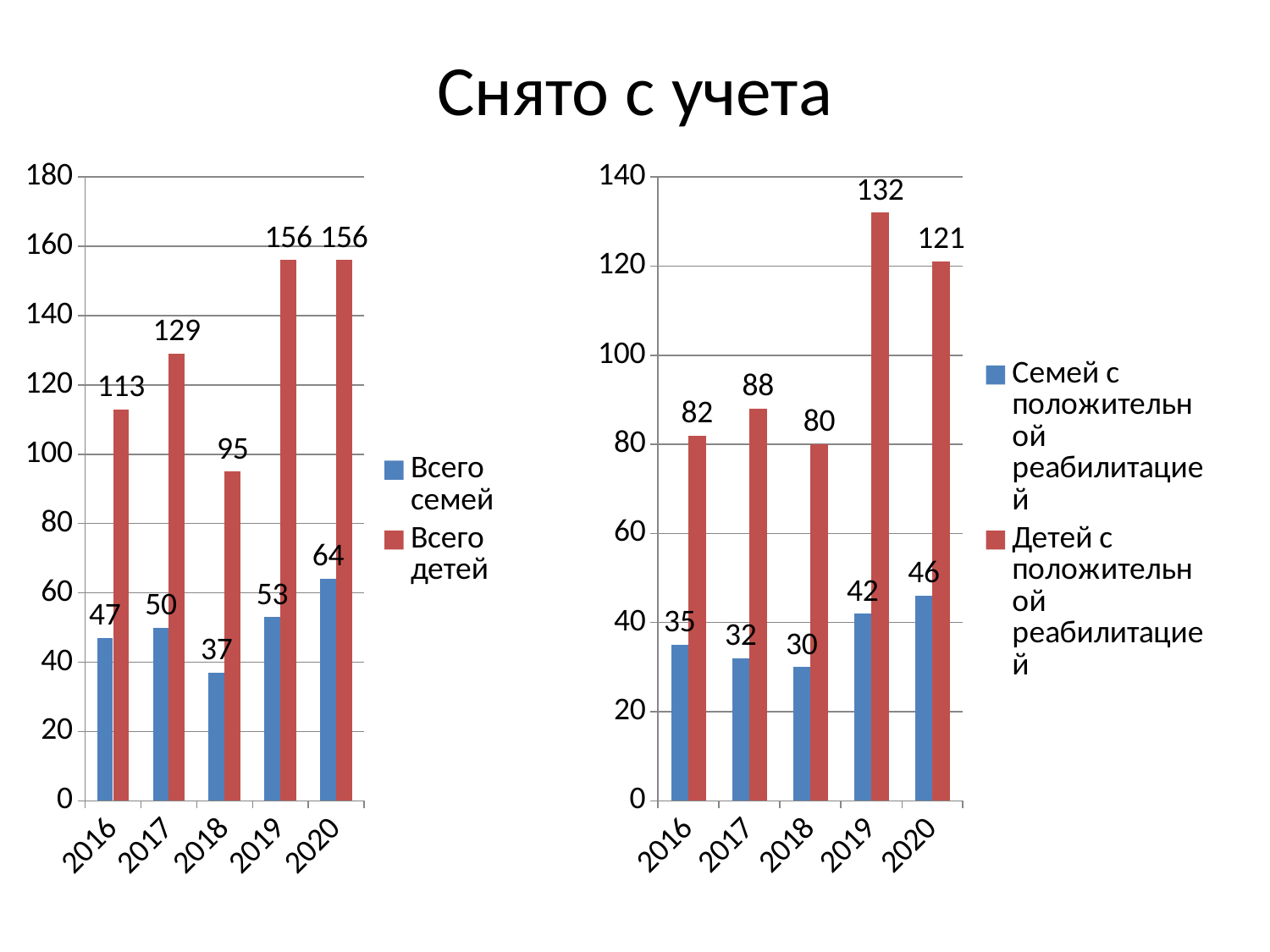
In the left chart, which year has the lowest value for Всего детей? 2018 In the left chart, what is the value for Всего семей in 2018? 37 In the right chart, which year has the highest value for Семей с положительной реабилитацией? 2020 In the left chart, what is the value for Всего детей in 2017? 129 In the right chart, how many years are shown on the x axis? 5 In the right chart, what is the value for Детей с положительной реабилитацией in 2019? 132 What kind of chart is the right chart? bar chart In the right chart, which is larger: Детей с положительной реабилитацией in 2016 or in 2018? 2016 What is the title of the slide? Снято с учета In the right chart, what is the value for Семей с положительной реабилитацией in 2016? 35 In the left chart, how many series does the legend list? 2 In the left chart, what is the difference between Всего детей and Всего семей in 2020? 92